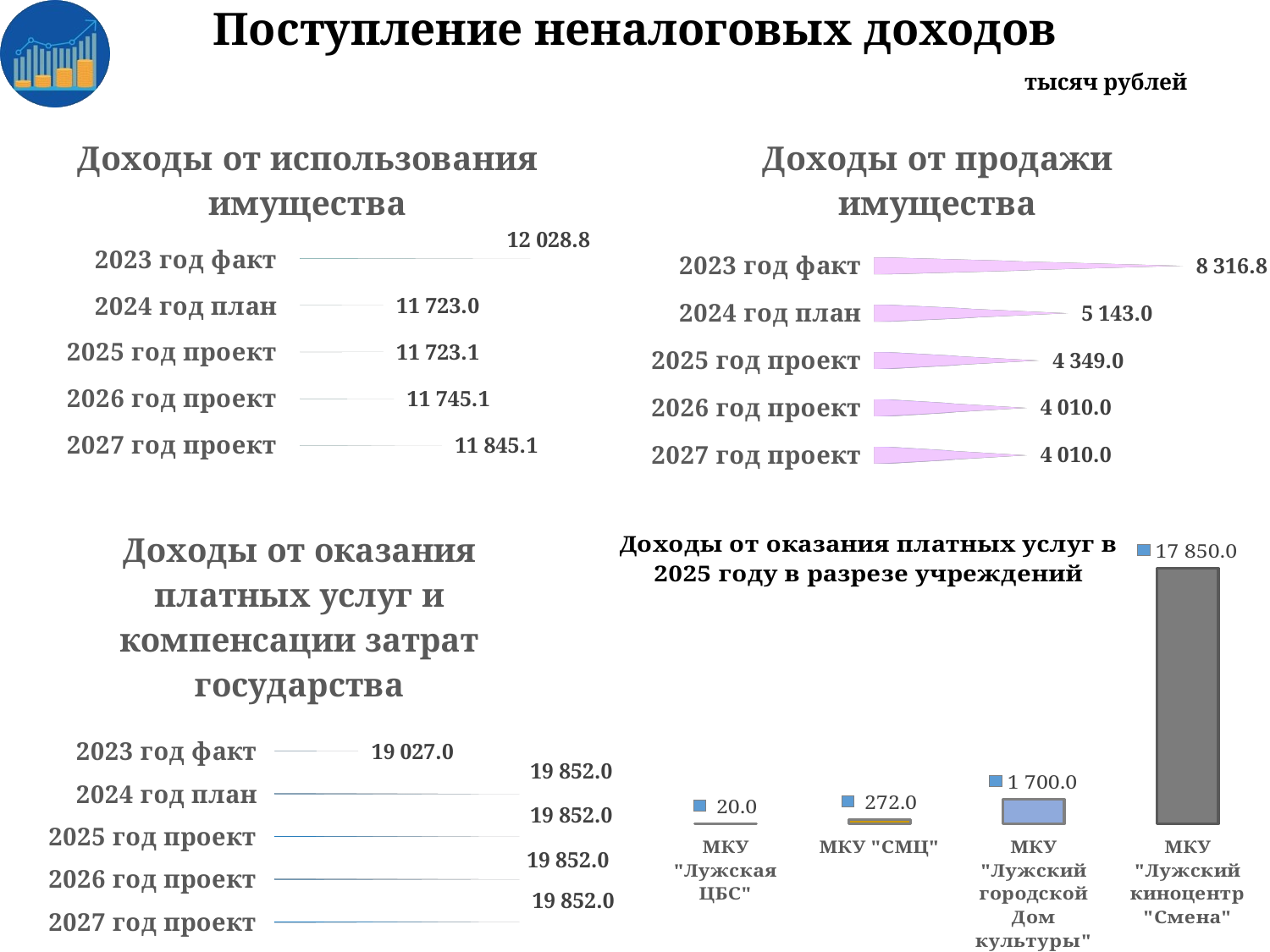
What kind of chart is "Доходы от оказания платных услуг в 2025 году в разрезе учреждений"? bar chart In the chart "Доходы от оказания платных услуг в 2025 году в разрезе учреждений", which institution has the highest value? МКУ "Лужский киноцентр "Смена"" In the chart "Доходы от продажи имущества", what is the value for "2024 год план"? 5 143.0 In the chart "Доходы от оказания платных услуг в 2025 году в разрезе учреждений", what is the difference between МКУ "Лужский городской Дом культуры" and МКУ "Лужская ЦБС"? 1 680.0 In the chart "Доходы от использования имущества", which category has the lowest value? 2024 год план In the chart "Доходы от продажи имущества", what is the difference between "2023 год факт" and "2025 год проект"? 3 967.8 In the chart "Доходы от продажи имущества", how many categories are shown? 5 In the chart "Доходы от продажи имущества", do the values rise or fall from "2023 год факт" to "2027 год проект"? fall In the chart "Доходы от оказания платных услуг в 2025 году в разрезе учреждений", what is the value for МКУ "СМЦ"? 272.0 In the chart "Доходы от оказания платных услуг и компенсации затрат государства", which is larger: "2023 год факт" or "2024 год план"? 2024 год план In the chart "Доходы от оказания платных услуг и компенсации затрат государства", what is the value for "2023 год факт"? 19 027.0 In the chart "Доходы от использования имущества", what is the value for "2023 год факт"? 12 028.8